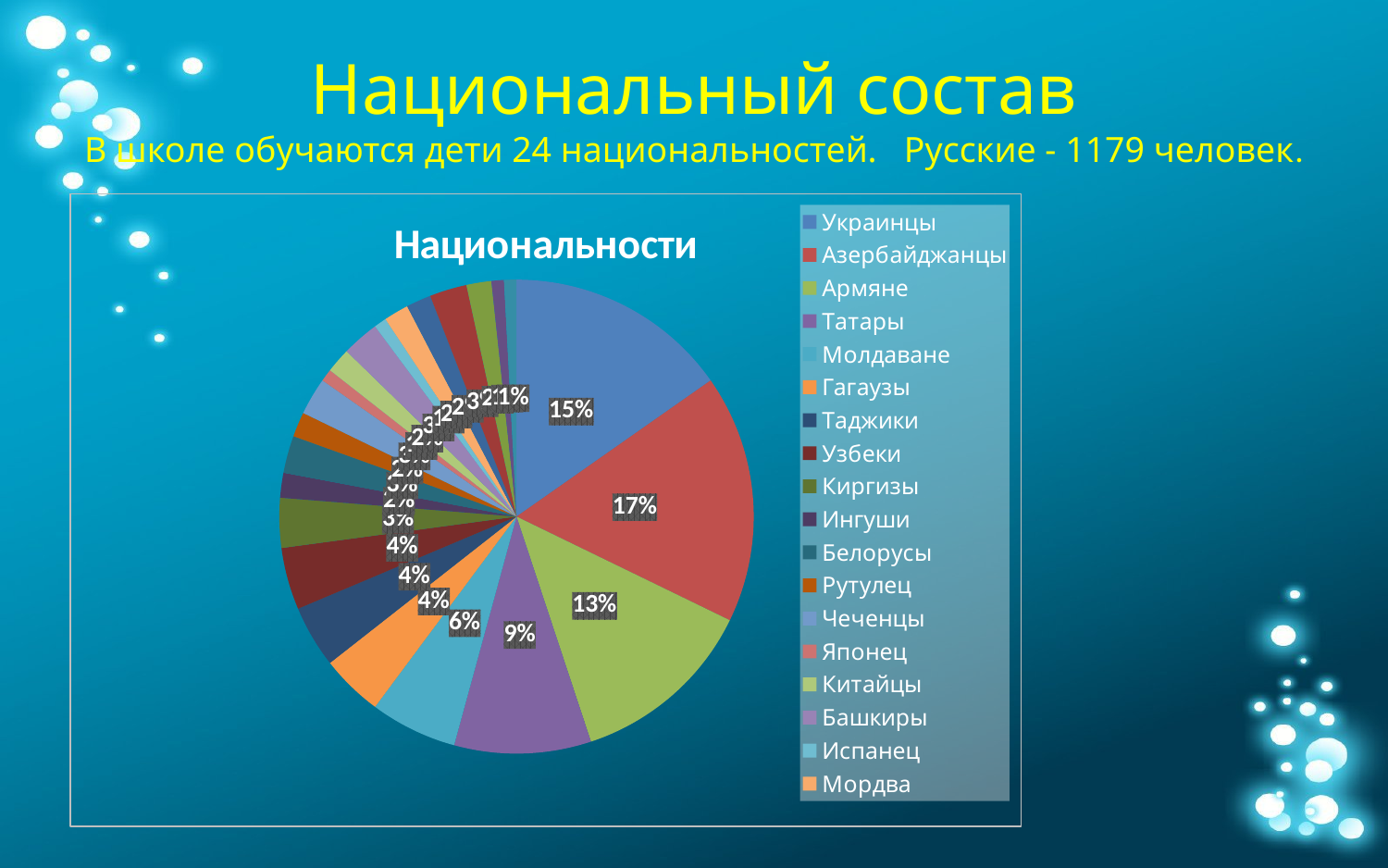
Which nationality is listed first in the legend? Украинцы What percentage is shown for Татары? 9% By how many percentage points does the Азербайджанцы slice exceed the Татары slice? 8 What percentage is shown for Украинцы? 15% What percentage is shown for Армяне? 13% What is the title of the chart? Национальности What percentage is shown for Молдаване? 6% What share of the pie is labelled for Азербайджанцы? 17% Which nationality has the largest slice of the pie? Азербайджанцы Which slice is larger, Украинцы or Армяне? Украинцы Which slice is larger, Татары or Молдаване? Татары What kind of chart is shown on the slide? pie chart